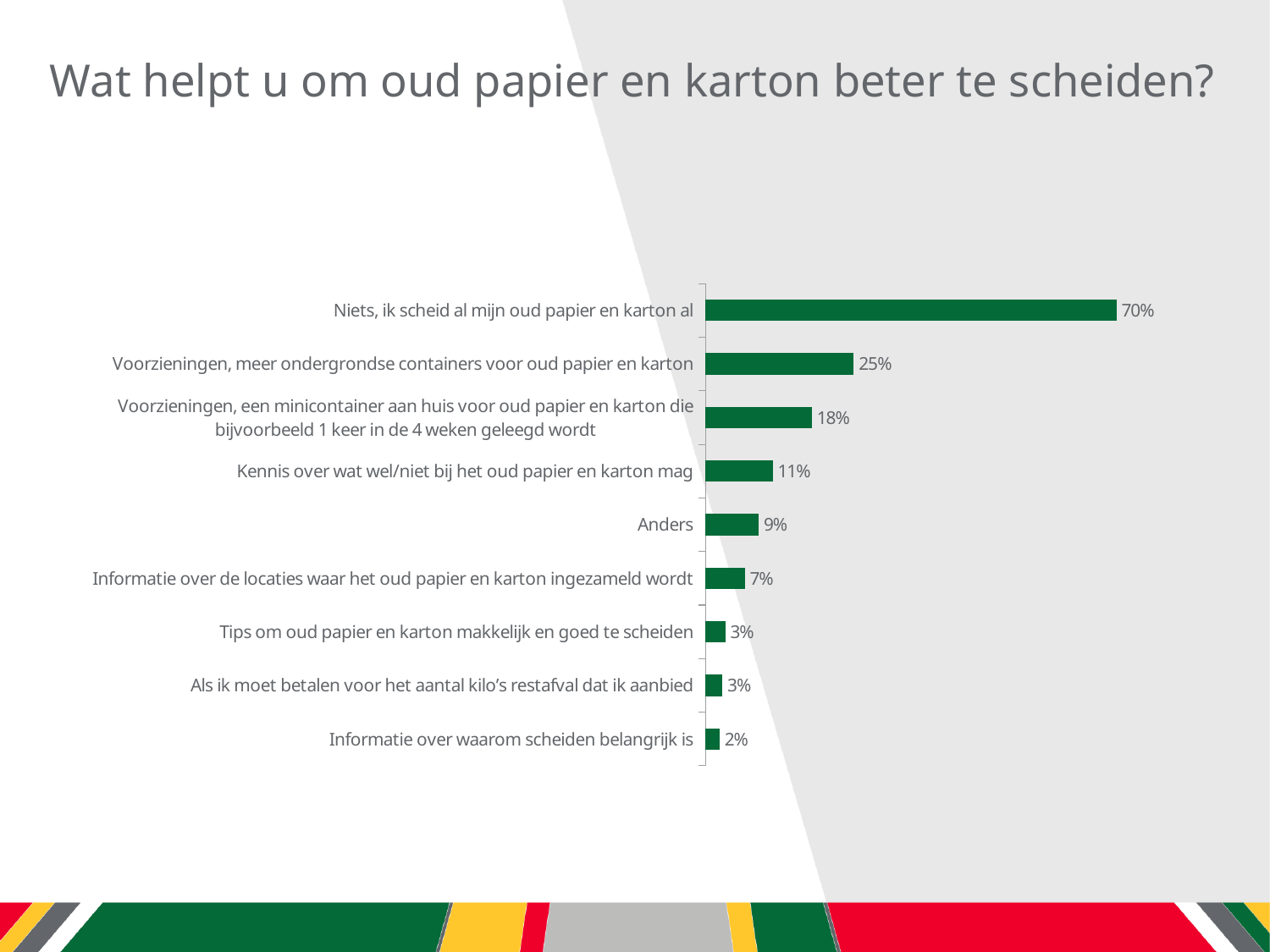
What colour are the bars in the chart? Green What is the title of the slide? Wat helpt u om oud papier en karton beter te scheiden? What is the value for "Anders"? 9% How many categories are shown in the chart? 9 Which category has the highest value? Niets, ik scheid al mijn oud papier en karton al Which is larger: the value for "Anders" or the value for "Informatie over de locaties waar het oud papier en karton ingezameld wordt"? Anders What is the value for "Kennis over wat wel/niet bij het oud papier en karton mag"? 11% What kind of chart is shown on the slide? Bar chart What is the value for "Informatie over waarom scheiden belangrijk is"? 2% What is the difference between the values for "Voorzieningen, meer ondergrondse containers voor oud papier en karton" and "Voorzieningen, een minicontainer aan huis voor oud papier en karton die bijvoorbeeld 1 keer in de 4 weken geleegd wordt"? 7% What is the value for "Niets, ik scheid al mijn oud papier en karton al"? 70% Which category has the lowest value? Informatie over waarom scheiden belangrijk is